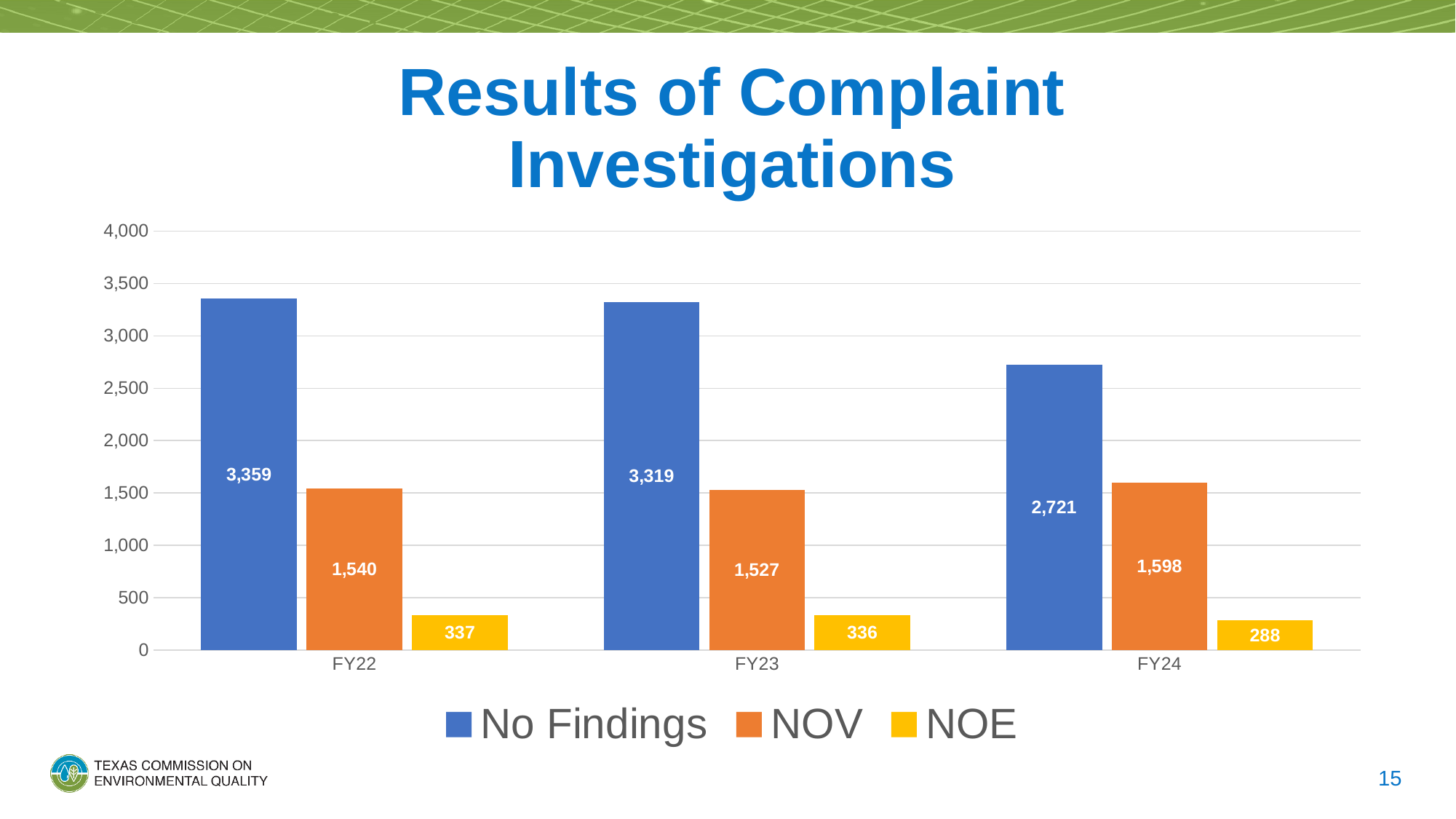
Does the No Findings value rise or fall from FY22 to FY24? fall How many fiscal years are shown on the x axis? 3 What is the value for NOV in FY24? 1,598 What is the value for No Findings in FY22? 3,359 Which fiscal year has the highest No Findings value? FY22 What is the value for NOE in FY23? 336 How many series does the legend list? 3 Is the value for No Findings in FY24 greater or less than 3,000? less What kind of chart is shown on the slide? bar chart Which fiscal year has the lowest NOE value? FY24 What is the difference between the No Findings values for FY23 and FY24? 598 Which is larger, the NOV value for FY22 or the NOV value for FY24? FY24